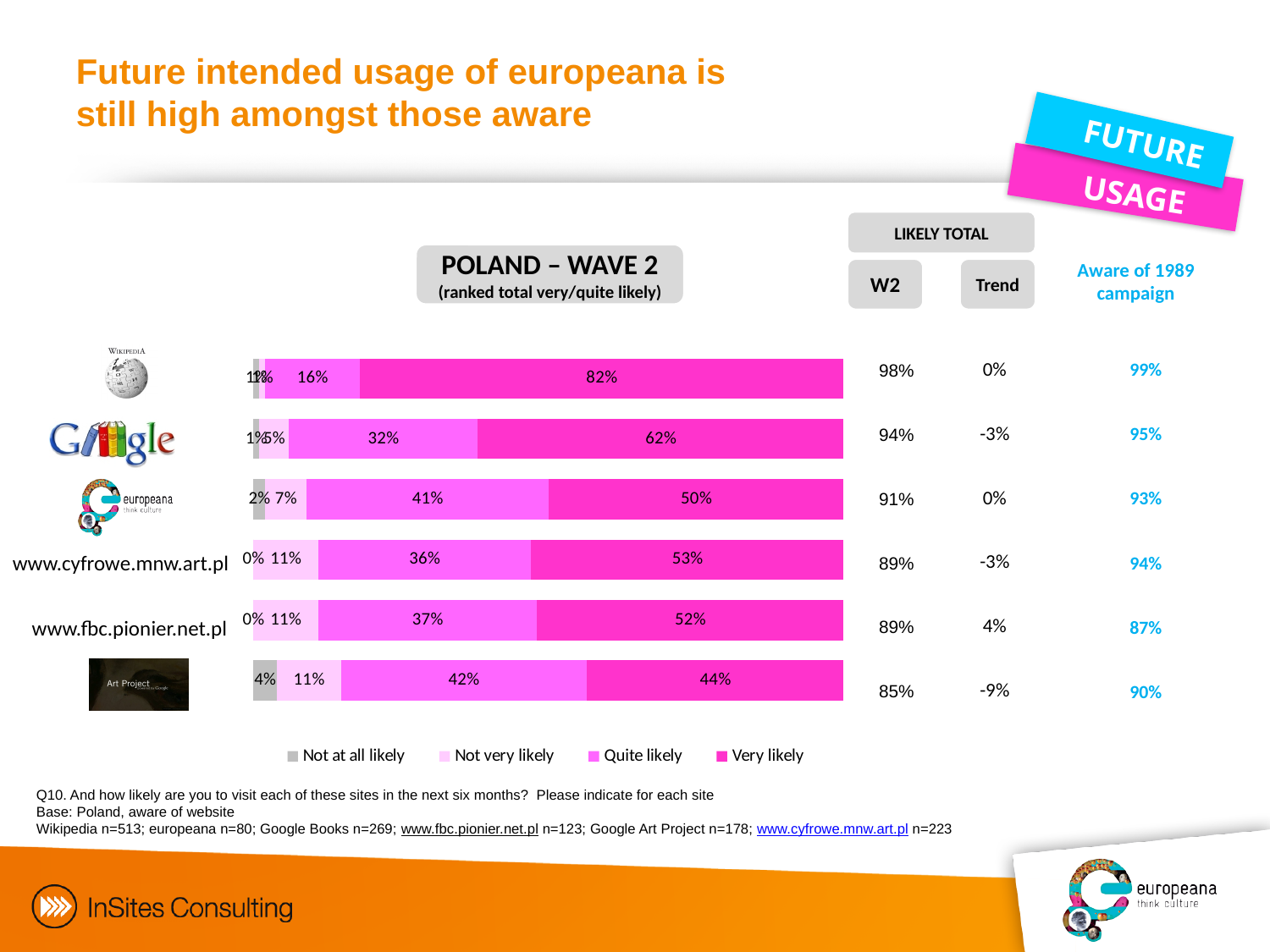
What percentage of respondents are 'Very likely' to visit www.cyfrowe.mnw.art.pl? 53% What is the combined 'Quite likely' and 'Very likely' share for www.cyfrowe.mnw.art.pl? 89% What is the title shown above the chart? POLAND – WAVE 2 (ranked total very/quite likely) Which site has the lowest 'Very likely' share? Art Project How many sites are shown in the chart? 6 Which has a larger 'Quite likely' share: europeana or www.fbc.pionier.net.pl? europeana What is the 'Quite likely' value for www.fbc.pionier.net.pl? 37% What type of chart is shown on the slide? Stacked bar chart What is the 'Not very likely' value for europeana? 7% Which site has the highest 'Very likely' share? Wikipedia What is the difference between the 'Very likely' values for www.cyfrowe.mnw.art.pl and www.fbc.pionier.net.pl? 1% How many series does the legend list? 4